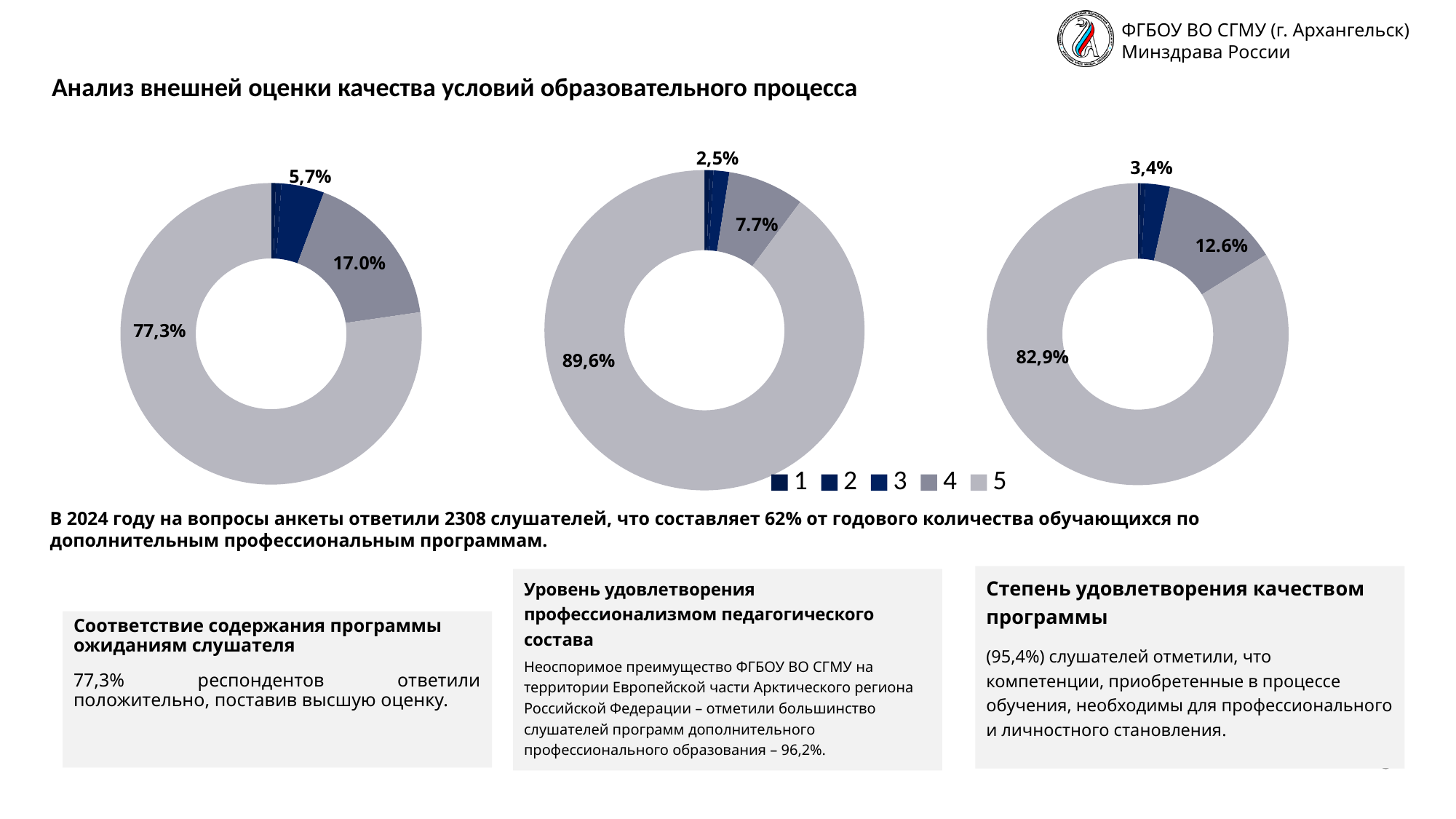
In the right donut chart, what is the value of the smallest slice? 3,4% In the middle donut chart, what is the value of the smallest slice? 2,5% Which is larger: the medium grey slice in the left chart (17.0%) or the medium grey slice in the right chart (12.6%)? The left chart (17.0%) In the middle donut chart, what value is shown for the largest slice? 89,6% What is the difference between the largest slice of the middle chart (89,6%) and the largest slice of the right chart (82,9%)? 6,7% In the right donut chart, what value is shown for the largest slice? 82,9% What kind of charts are shown on the slide? Donut (pie) charts In the left donut chart, what is the value of the smallest slice? 5,7% How many entries does the shared legend below the charts list? 5 Which of the three donut charts has the largest single slice? The middle chart (89,6%) How many labelled slices does the middle donut chart have? 3 In the left donut chart, what value is shown for the largest slice? 77,3%